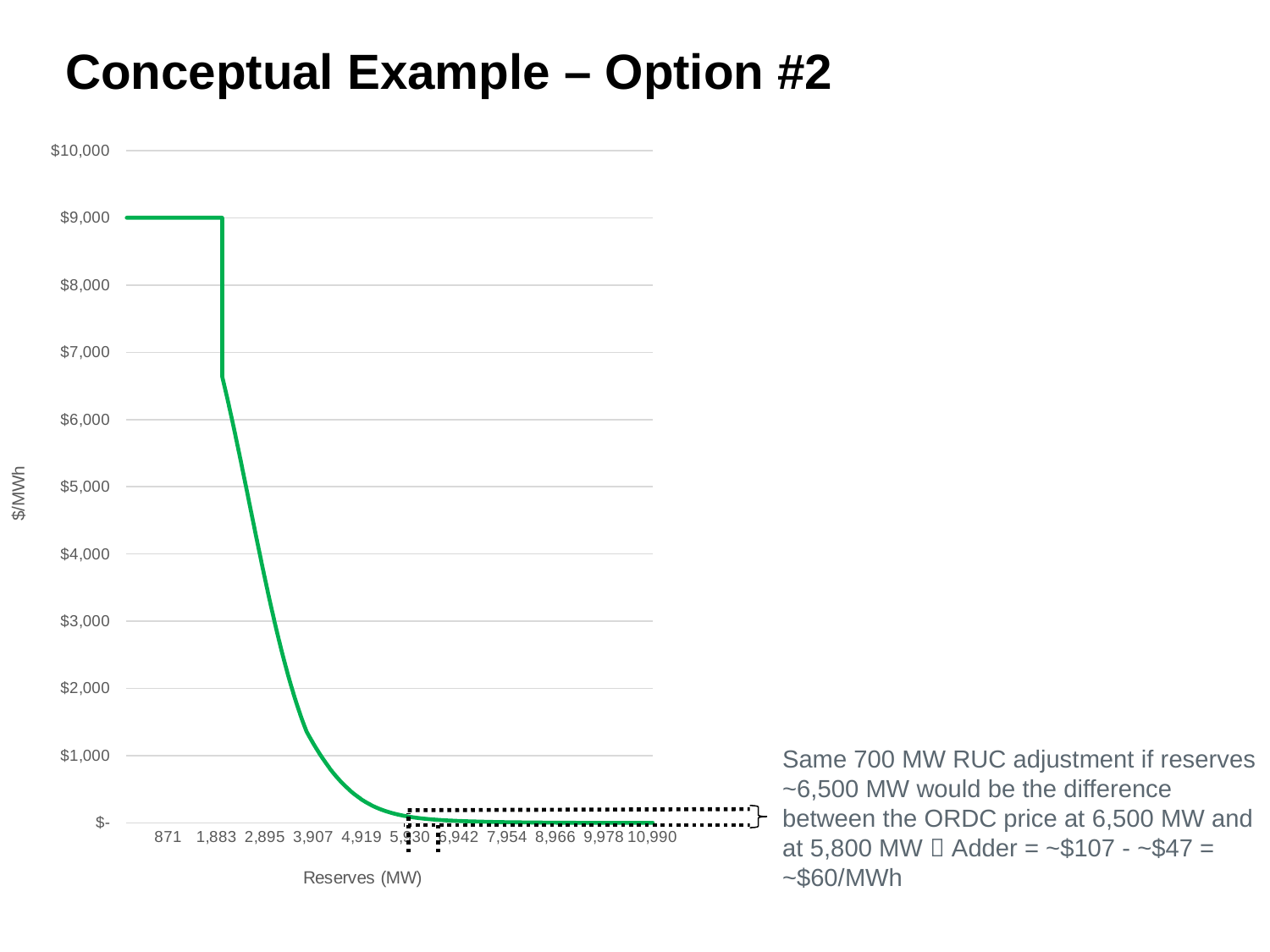
What is the title of the x axis? Reserves (MW) Is the value at 4,919 MW greater or less than $1,000? less How many reserve levels are labelled on the x axis? 11 Which is larger, the value at 871 MW or the value at 10,990 MW? 871 MW What is the $/MWh value at 1,883 MW of reserves? $9,000 At which labelled reserve level on the x axis is the value lowest? 10,990 What is the $/MWh value at 871 MW of reserves? $9,000 Do the values on the chart rise or fall as reserves increase along the x axis? fall What kind of chart is shown on the slide? line chart Is the value at 3,907 MW greater or less than $3,000? less Is the value at 10,990 MW greater or less than $1,000? less